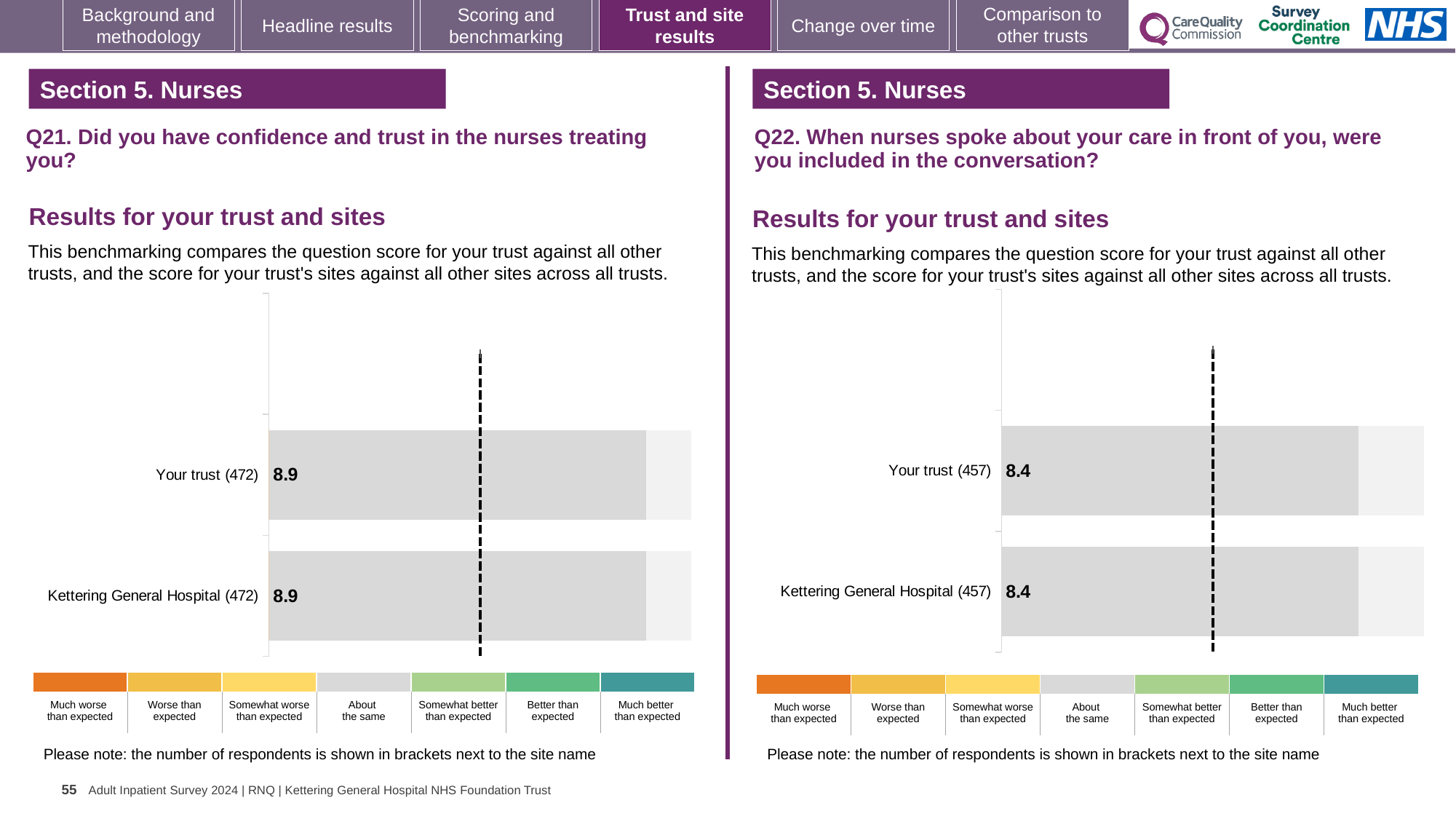
What kind of chart is used on the Q21 chart (left)? Bar chart How many bars are plotted on the Q22 chart (right)? 2 On the Q21 chart (left), what is the score for Kettering General Hospital? 8.9 How many bars are plotted on the Q21 chart (left)? 2 On the Q21 chart (left), how many respondents are shown in brackets next to Your trust? 472 Is the Your trust score on the Q21 chart (left) larger or smaller than the Your trust score on the Q22 chart (right)? Larger On the Q22 chart (right), how many respondents are shown in brackets next to Kettering General Hospital? 457 On the Q22 chart (right), what is the score for Kettering General Hospital? 8.4 On the Q22 chart (right), what is the score for Your trust? 8.4 On the Q21 chart (left), what is the score for Your trust? 8.9 On the Q22 chart (right), what is the difference between the Your trust score and the Kettering General Hospital score? 0 On the Q21 chart (left), what is the difference between the Your trust score and the Kettering General Hospital score? 0